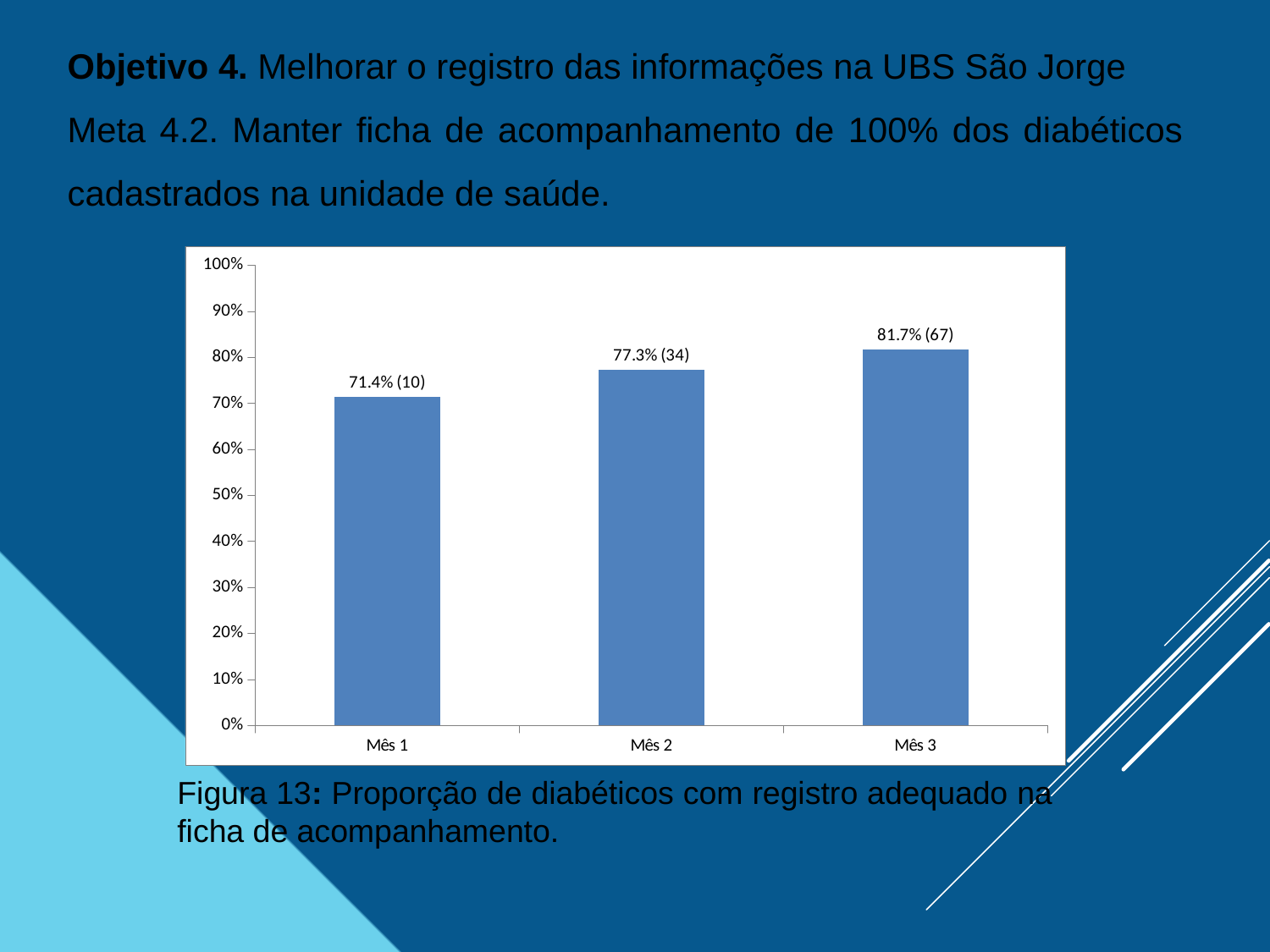
Is the value for Mês 3 greater or less than 80%? greater How many months are shown on the x axis? 3 Which is larger, the value for Mês 2 or the value for Mês 1? Mês 2 Which month has the lowest proportion? Mês 1 Do the values rise or fall from Mês 1 to Mês 3? rise Which month has the highest proportion? Mês 3 What is the value shown for Mês 3? 81.7% (67) What is the value shown for Mês 2? 77.3% (34) What kind of chart is shown on the slide? bar chart What is the figure number given in the caption below the chart? Figura 13 What is the value shown for Mês 1? 71.4% (10) What is the difference in percentage points between Mês 3 and Mês 1? 10.3